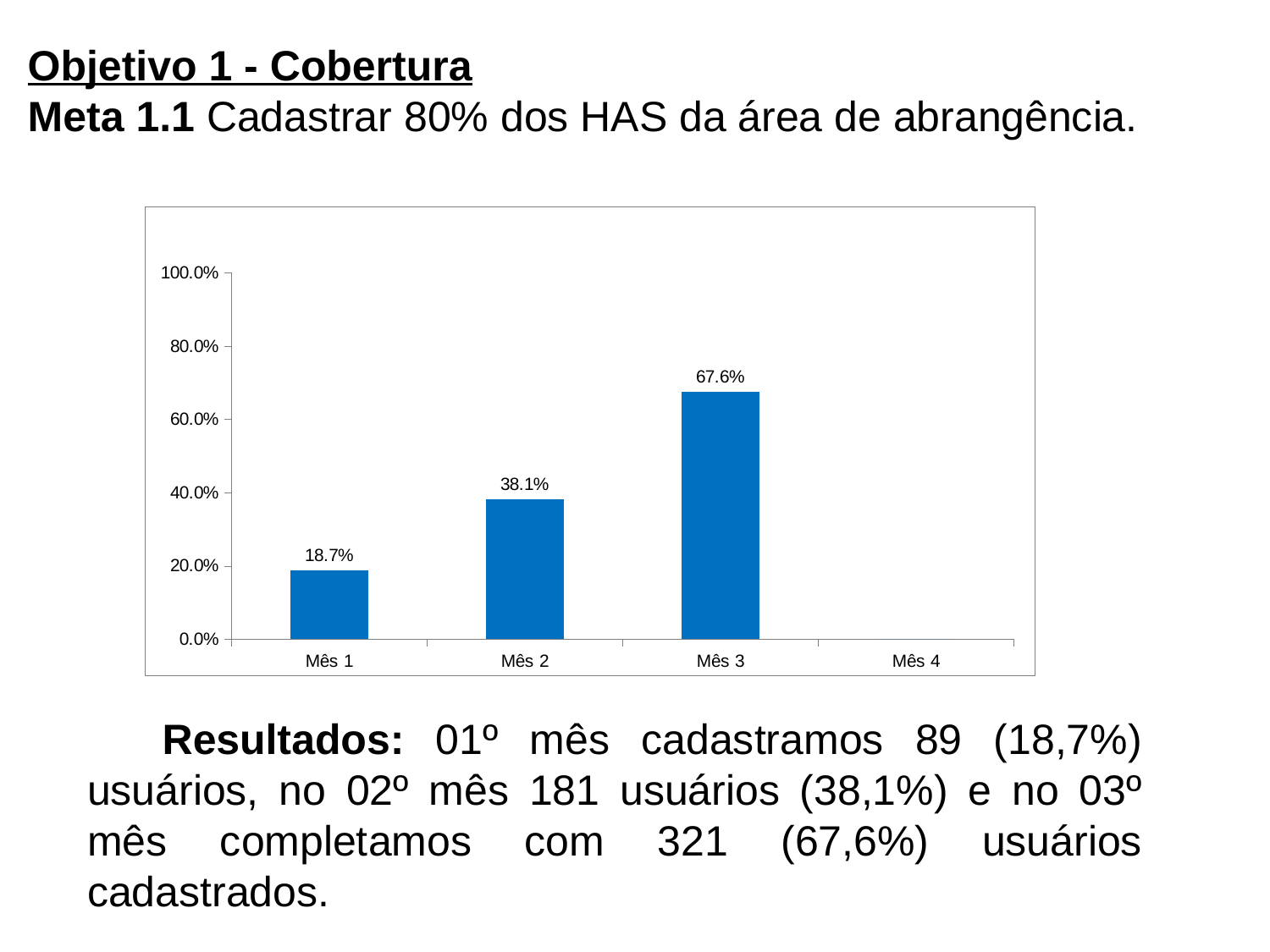
What is the value for Mês 3? 67.6% Which is larger, the value for Mês 2 or the value for Mês 3? Mês 3 What is the difference between the values for Mês 2 and Mês 1? 19.4% Among the months with a plotted bar, which has the lowest value? Mês 1 What kind of chart is shown on the slide? bar chart Is the value for Mês 3 greater or less than 80.0%? less How many categories are shown on the x axis? 4 Do the values rise or fall from Mês 1 to Mês 3? rise Which month has the highest value? Mês 3 What is the difference between the values for Mês 3 and Mês 2? 29.5% What is the value for Mês 1? 18.7% What is the value for Mês 2? 38.1%